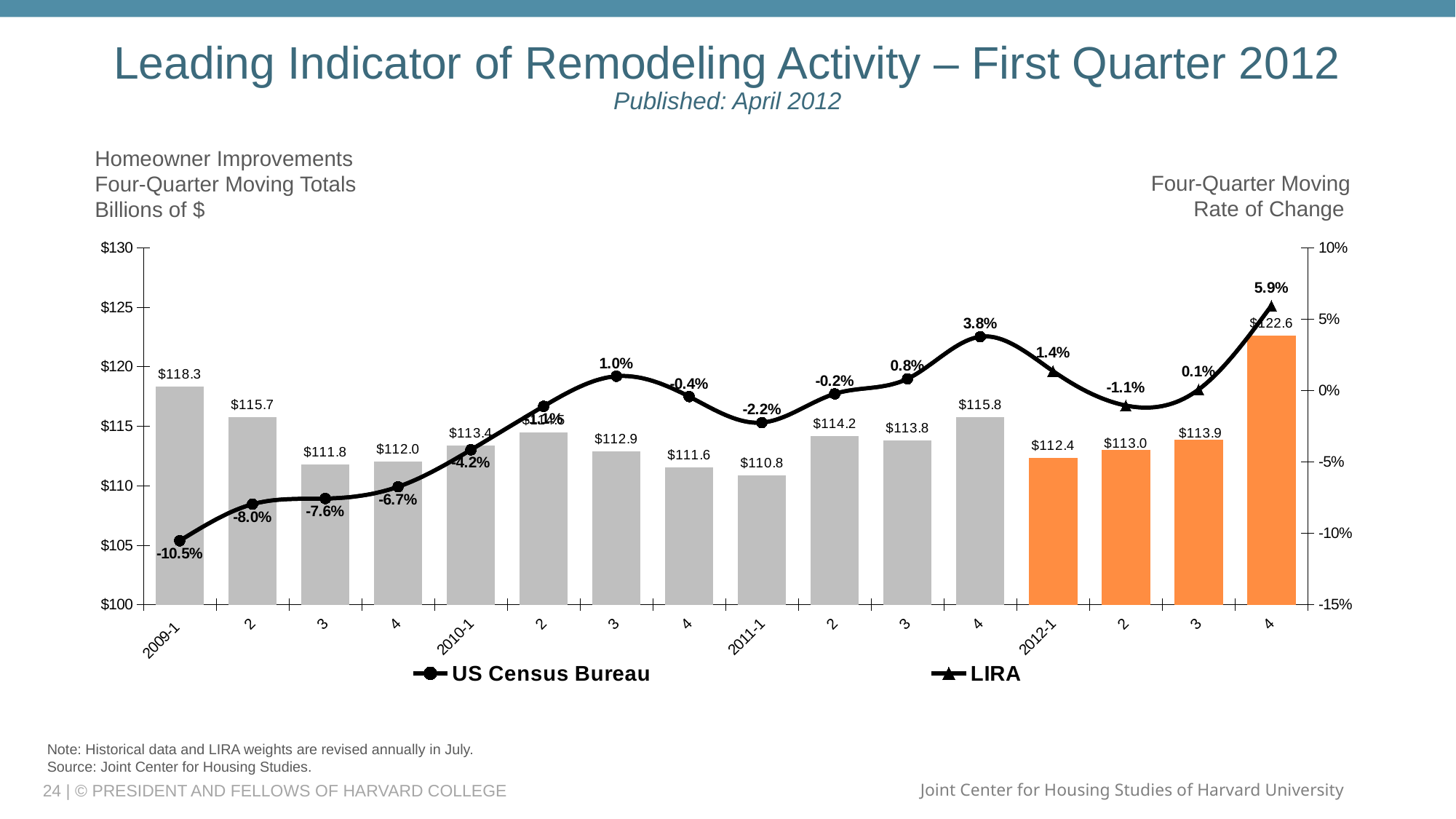
How many series does the legend list? 2 What is the Homeowner Improvements four-quarter moving total for 2009-1? $118.3 What kind of chart is shown on the slide? A combination bar and line chart What is the difference between the four-quarter moving totals for 2012-4 and 2012-1? $10.2 What is the four-quarter moving rate of change shown for 2011-4? 3.8% Which quarter has the highest Homeowner Improvements four-quarter moving total bar? 2012-4 What is the four-quarter moving rate of change shown for 2012-4? 5.9% Which quarter has the lowest four-quarter moving rate of change on the line? 2009-1 What is the difference between the four-quarter moving totals for 2009-1 and 2009-2? $2.6 Which quarter has the lowest Homeowner Improvements four-quarter moving total bar? 2011-1 Which has the larger four-quarter moving total, 2011-4 or 2011-2? 2011-4 How many quarterly bars are plotted on the chart? 16